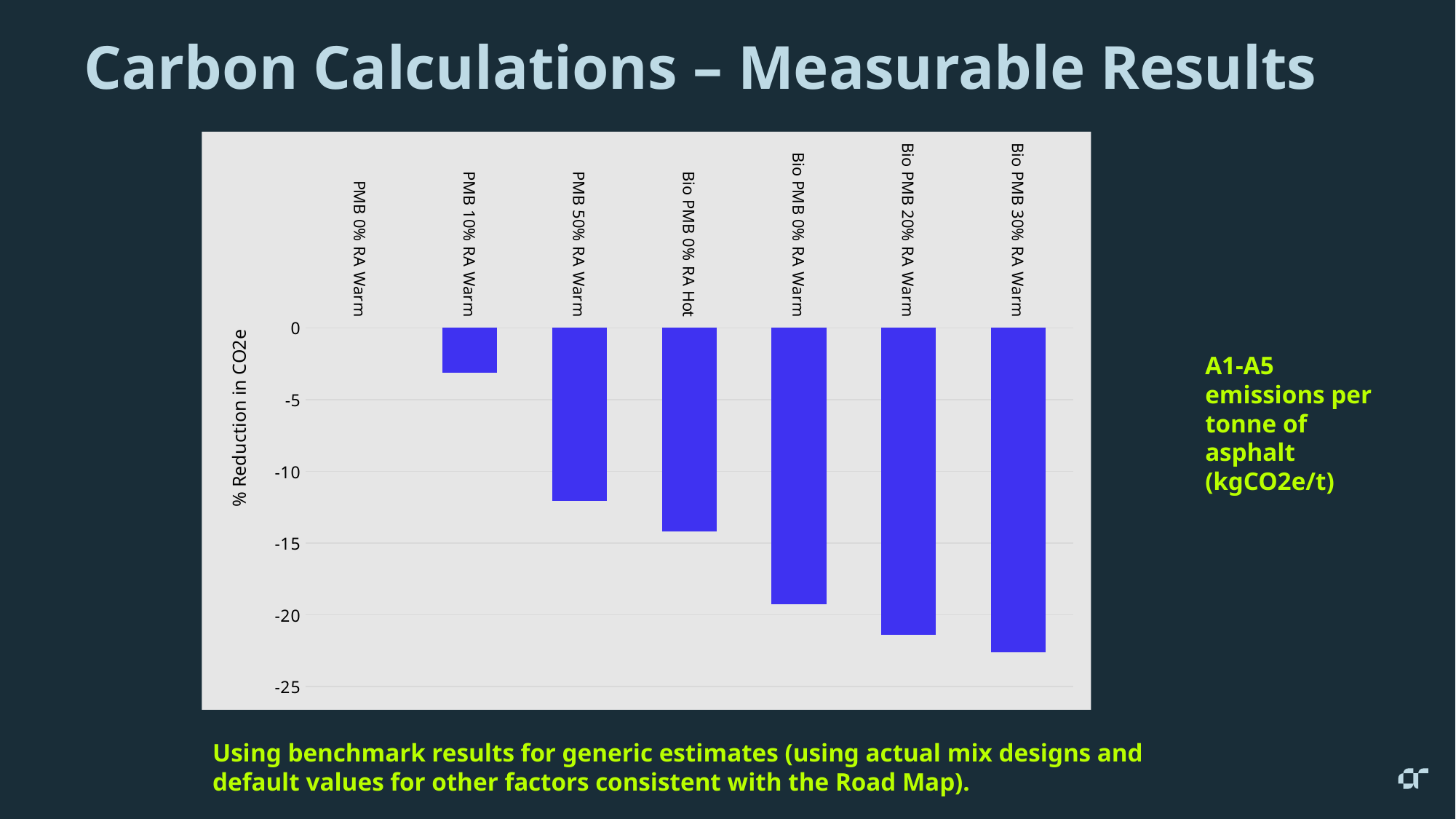
How many categories are shown on the x axis of the chart? 7 What colour are the bars in the chart? blue Is the value for PMB 10% RA Warm greater or less than -5? greater What is the title of the vertical axis of the chart? % Reduction in CO2e What kind of chart is shown on the slide? bar chart Which category has the lowest value (largest reduction) in the chart? Bio PMB 30% RA Warm Is the value for Bio PMB 20% RA Warm greater or less than -20? less Do the values rise or fall moving from left to right along the x axis? fall Which category has the highest value in the chart? PMB 0% RA Warm Is the value for Bio PMB 0% RA Warm greater or less than -15? less Which has the larger value, PMB 50% RA Warm or Bio PMB 0% RA Hot? PMB 50% RA Warm